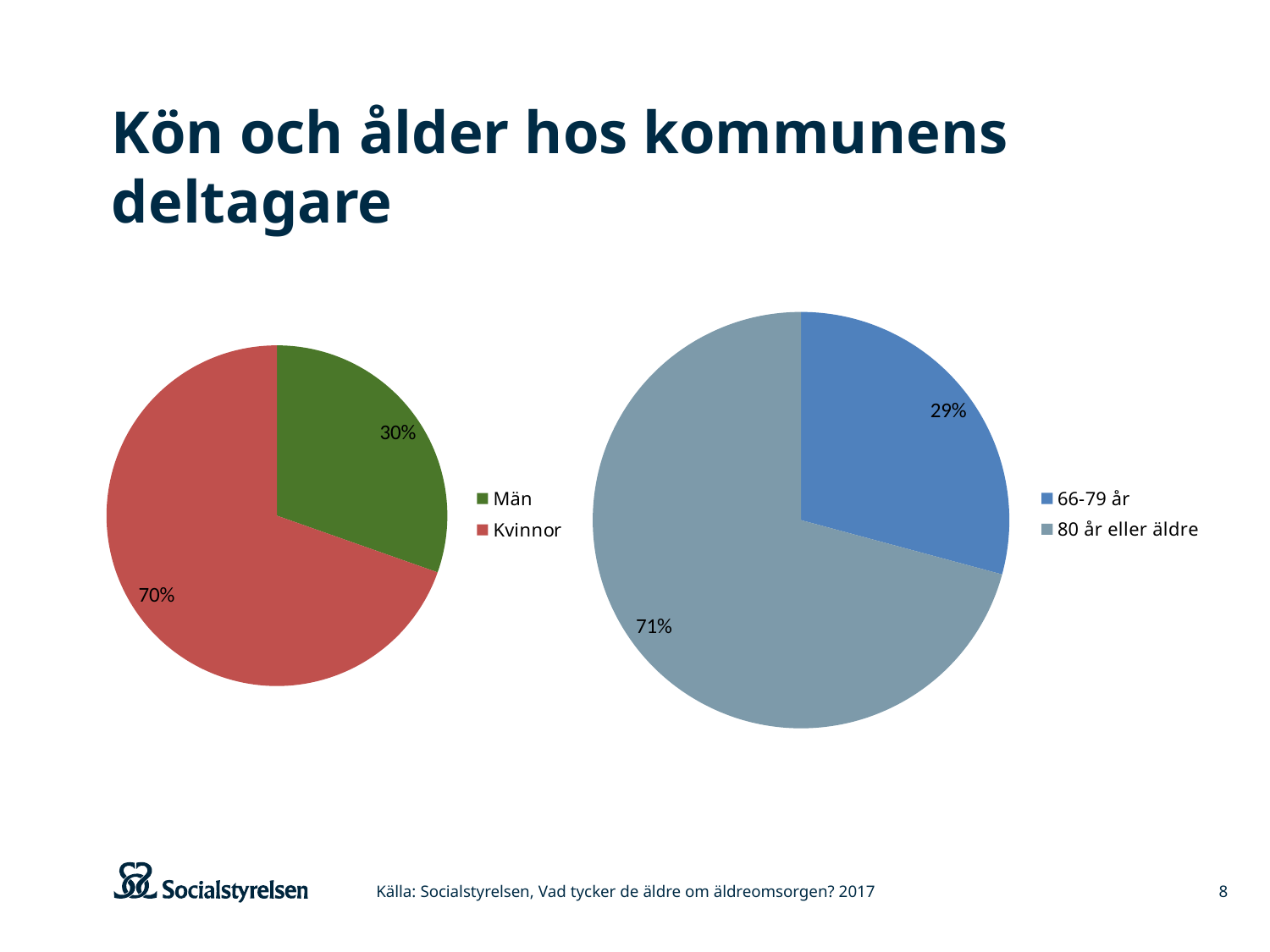
In the right pie chart (age), what share of participants are 66-79 år? 29% In the left pie chart (gender), which category has the largest share? Kvinnor In the left pie chart (gender), what share of participants are Män? 30% In the left pie chart, what colour is the Kvinnor slice? Red Which is larger: the share of Män in the left pie chart or the share of 66-79 år in the right pie chart? Män In the right pie chart (age), which category has the smallest share? 66-79 år What type of chart is used on the left side of the slide? Pie chart How many slices does the right pie chart (age) have? 2 In the left pie chart (gender), what is the difference in percentage points between Kvinnor and Män? 40 In the left pie chart (gender), what share of participants are Kvinnor? 70% In the right pie chart (age), what is the difference in percentage points between 80 år eller äldre and 66-79 år? 42 In the right pie chart (age), what share of participants are 80 år eller äldre? 71%